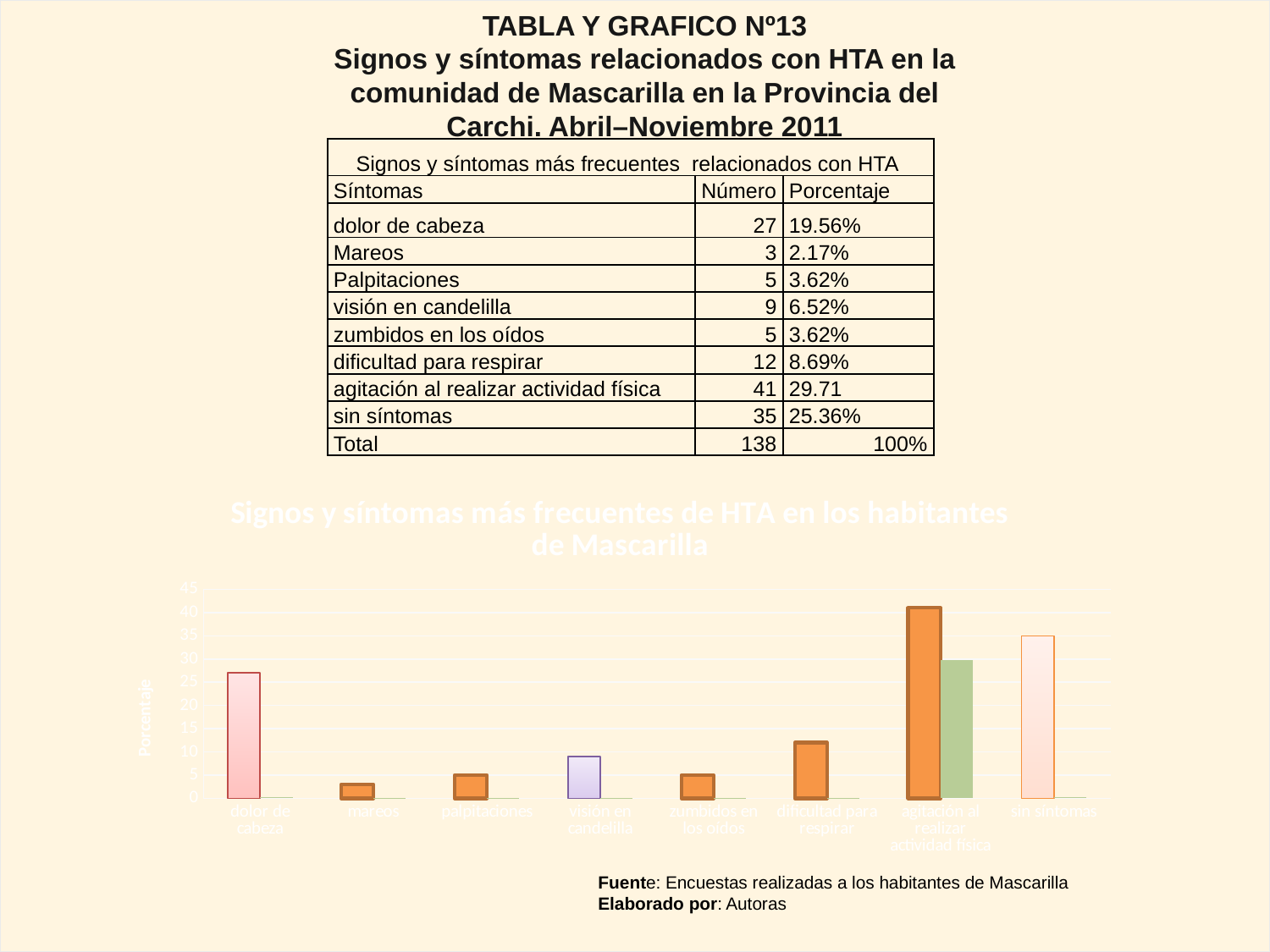
In the chart, which bar is taller: dificultad para respirar or palpitaciones? dificultad para respirar In the chart, which bar is taller: dolor de cabeza or sin síntomas? sin síntomas Which category has the shortest bar in the chart? mareos What is the title of the chart? Signos y síntomas más frecuentes de HTA en los habitantes de Mascarilla Is the value for dificultad para respirar in the chart greater or less than 15? less Is the value for mareos in the chart greater or less than 5? less Which category has the tallest bar in the chart? agitación al realizar actividad física What is the label on the vertical axis of the chart? Porcentaje Is the value for sin síntomas in the chart greater or less than 30? greater What kind of chart is shown on the slide? bar chart How many symptom categories are plotted along the x axis of the chart? 8